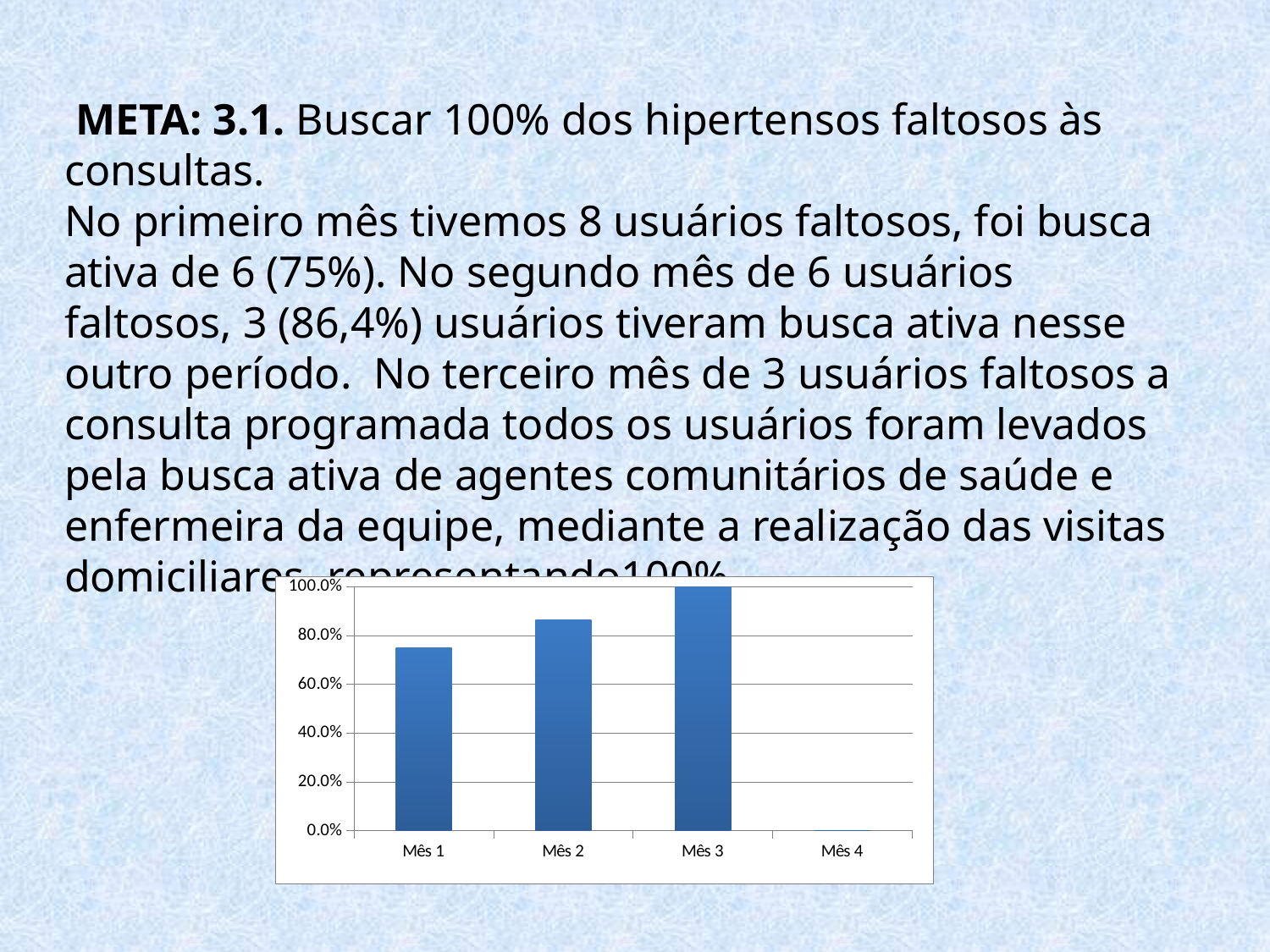
Is the value for Mês 1 greater or less than 80.0%? less Do the bar values rise or fall from Mês 1 to Mês 3? rise Among Mês 1, Mês 2 and Mês 3, which month has the lowest bar? Mês 1 Which x-axis category has no bar shown in the chart? Mês 4 Which is larger, the value for Mês 1 or the value for Mês 2? Mês 2 How many categories are labelled on the x axis of the chart? 4 What is the highest tick value shown on the y axis of the chart? 100.0% Is the value for Mês 1 greater or less than 60.0%? greater What kind of chart is shown on the slide? bar chart Which month has the highest bar in the chart? Mês 3 What value does the bar for Mês 3 reach on the y axis? 100.0% Is the value for Mês 2 greater or less than 80.0%? greater